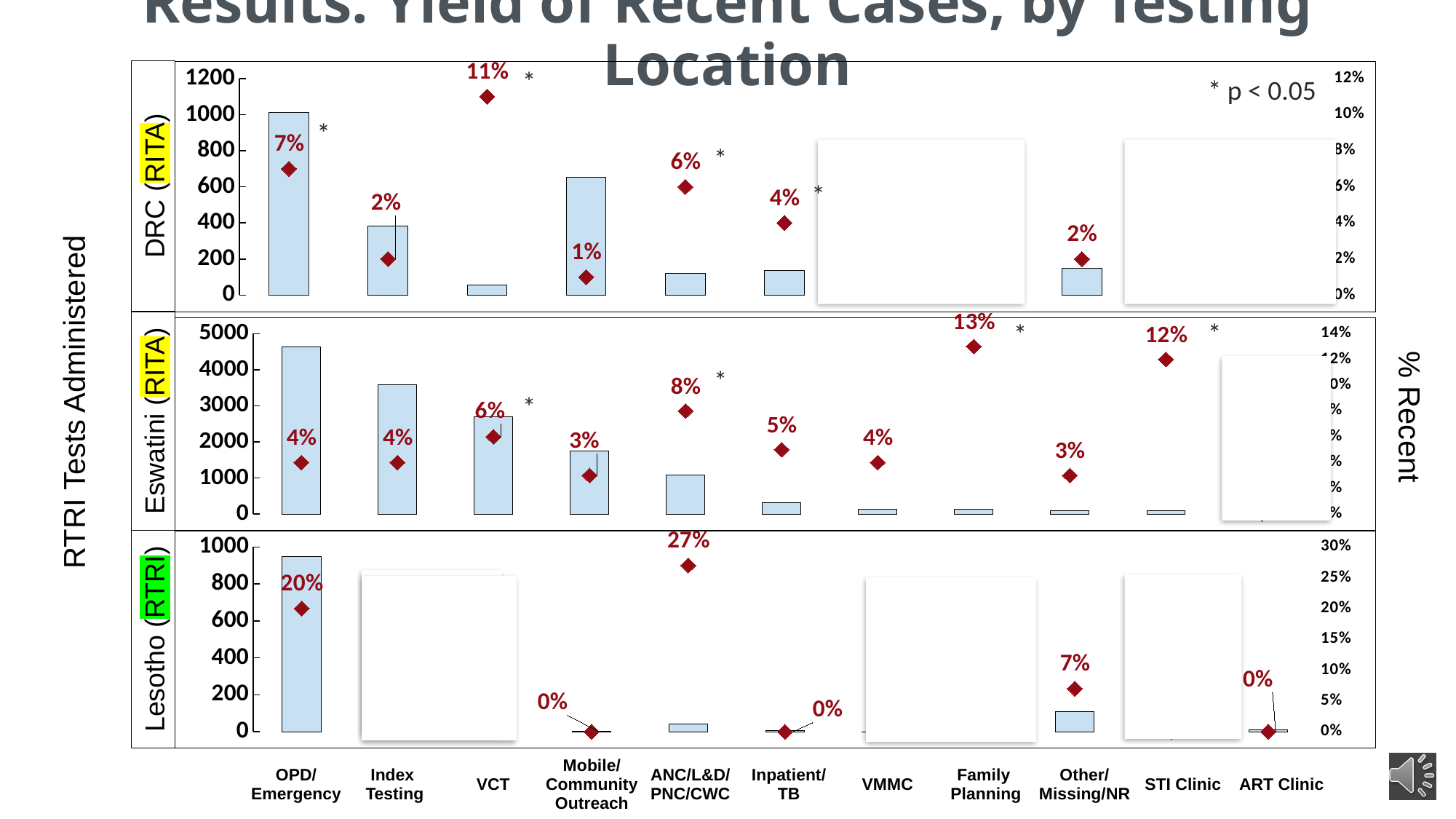
According to the note on the slide, what significance level does the asterisk (*) indicate? p < 0.05 In the Eswatini (RITA) chart, is the number of RTRI tests administered for OPD/Emergency greater or less than 4000? greater In the Lesotho (RTRI) chart, what is the % recent value shown for ANC/L&D/PNC/CWC? 27% In the Lesotho (RTRI) chart, what is the difference in percentage points between the % recent for ANC/L&D/PNC/CWC and for OPD/Emergency? 7 percentage points In the Lesotho (RTRI) chart, what is the % recent value shown for OPD/Emergency? 20% In the Lesotho (RTRI) chart, what is the % recent value shown for Other/Missing/NR? 7% In the DRC (RITA) chart, which testing location has the highest labeled % recent value? VCT In the DRC (RITA) chart, is the number of RTRI tests administered for OPD/Emergency greater or less than 800? greater In the DRC (RITA) chart, what is the % recent value shown for VCT? 11% In the Eswatini (RITA) chart, which testing location has the highest labeled % recent value? Family Planning In the Eswatini (RITA) chart, what is the % recent value shown for Family Planning? 13% In the Eswatini (RITA) chart, which has the higher % recent: ANC/L&D/PNC/CWC or Inpatient/TB? ANC/L&D/PNC/CWC